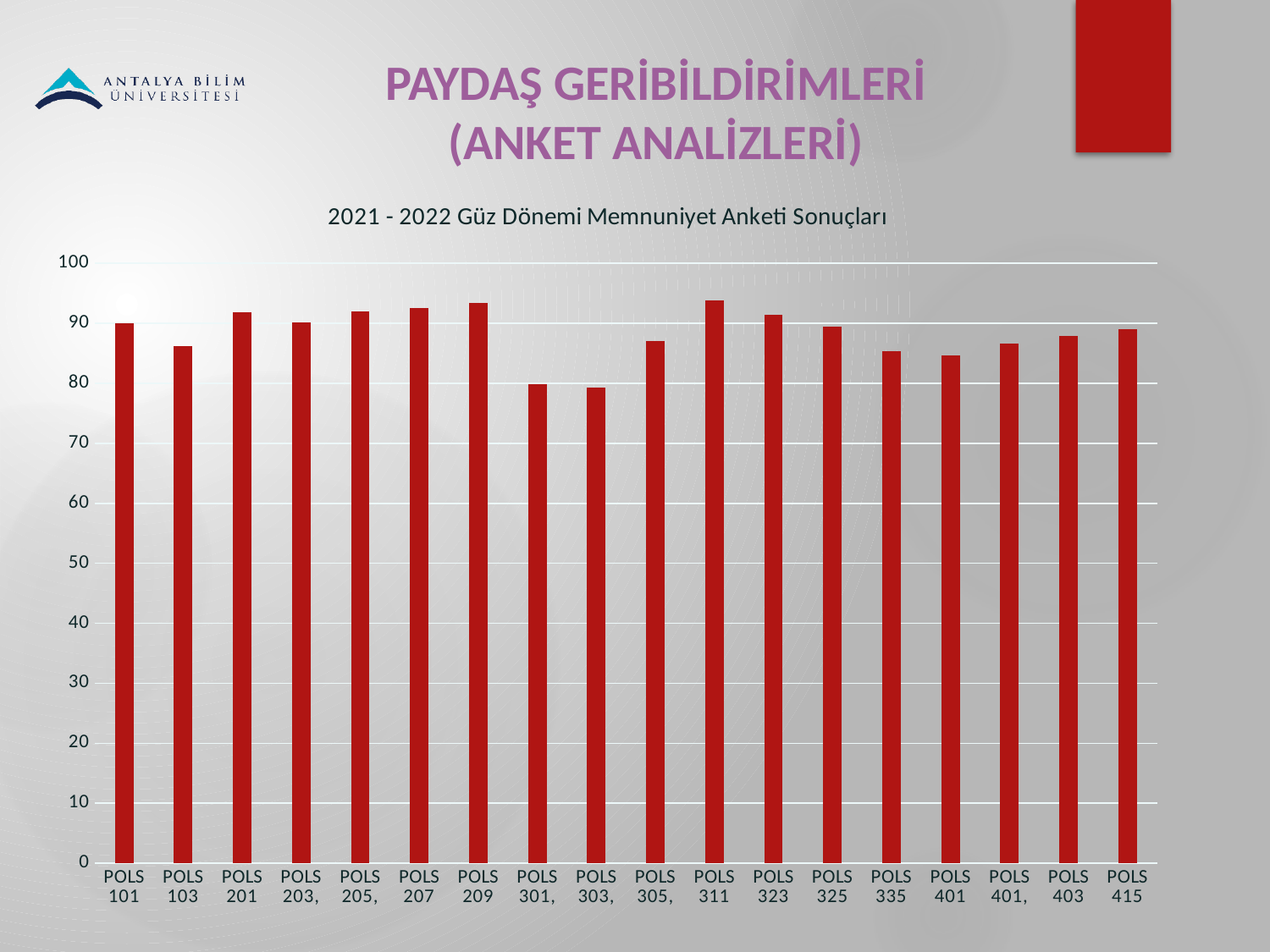
Which has the larger value, POLS 401 or POLS 207? POLS 207 Which has the larger value, POLS 311 or POLS 303? POLS 311 Is the value for POLS 207 greater or less than 90? greater Is the value for POLS 305 greater or less than 90? less What is the title of the chart? 2021 - 2022 Güz Dönemi Memnuniyet Anketi Sonuçları What kind of chart is shown on the slide? bar chart How many course categories are plotted on the x axis? 18 What colour are the bars in the chart? red Is the value for POLS 401 greater or less than 90? less Which has the larger value, POLS 201 or POLS 103? POLS 201